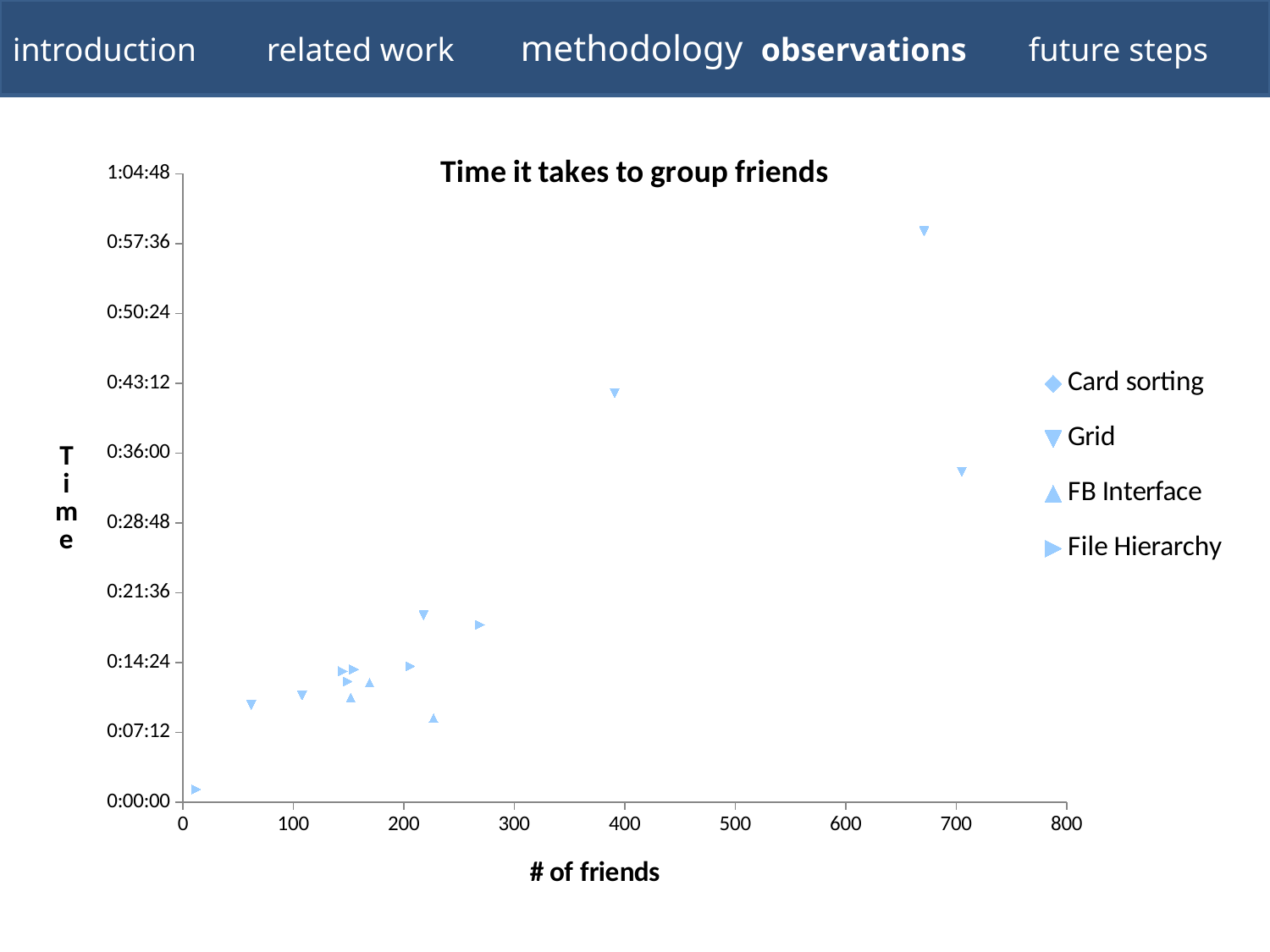
Which series does the point with the lowest time belong to? File Hierarchy What is the title of the chart? Time it takes to group friends Does the time generally rise or fall as the number of friends increases? rise What kind of chart is shown on the slide? scatter chart How many series does the legend list? 4 Is the time for the highest point (around 670 friends) greater or less than 0:50:24? greater Is the time for the File Hierarchy point near 0 friends greater or less than 0:07:12? less Which is larger: the time for the Grid point at around 670 friends or the Grid point at around 705 friends? the point at around 670 friends Is the time for the Grid point at around 705 friends greater or less than 0:36:00? less What is the label of the x axis? # of friends Which series does the point with the highest time belong to? Grid